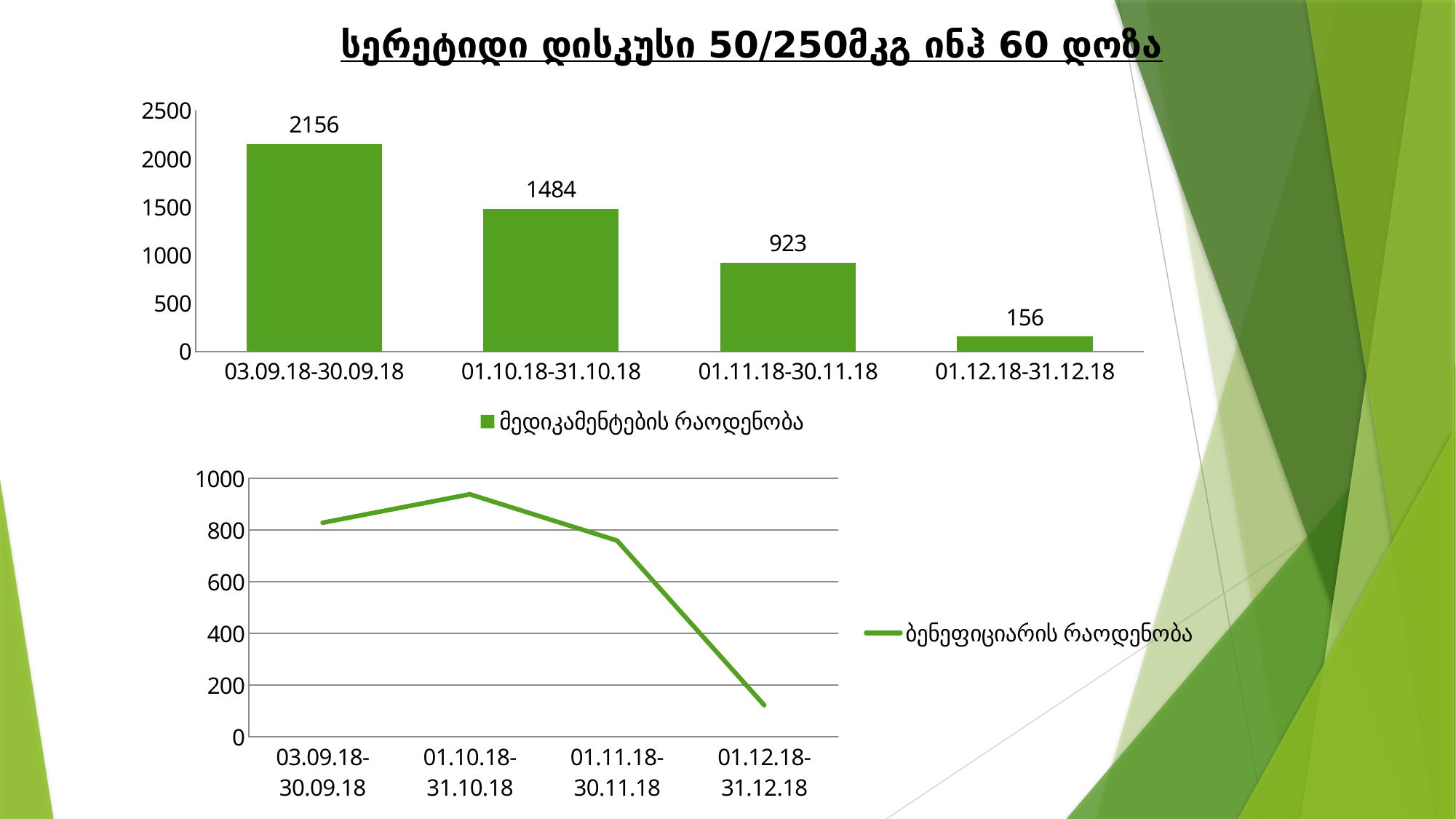
In the top bar chart, which period has the highest value? 03.09.18-30.09.18 In the bottom line chart, which period has the highest value? 01.10.18-31.10.18 In the bottom line chart, is the value for 01.12.18-31.12.18 greater or less than 200? less In the top bar chart, what is the value for 01.12.18-31.12.18? 156 In the top bar chart, what is the difference between the values for 01.10.18-31.10.18 and 01.11.18-30.11.18? 561 In the top bar chart, do the values rise or fall from left to right along the x axis? fall In the top bar chart, what is the value for 03.09.18-30.09.18? 2156 What kind of chart is the bottom chart on the slide? line chart In the bottom line chart, is the value for 01.10.18-31.10.18 greater or less than 800? greater In the top bar chart, which period has the lowest value? 01.12.18-31.12.18 In the top bar chart, how many periods are shown on the x axis? 4 What kind of chart is the top chart on the slide? bar chart